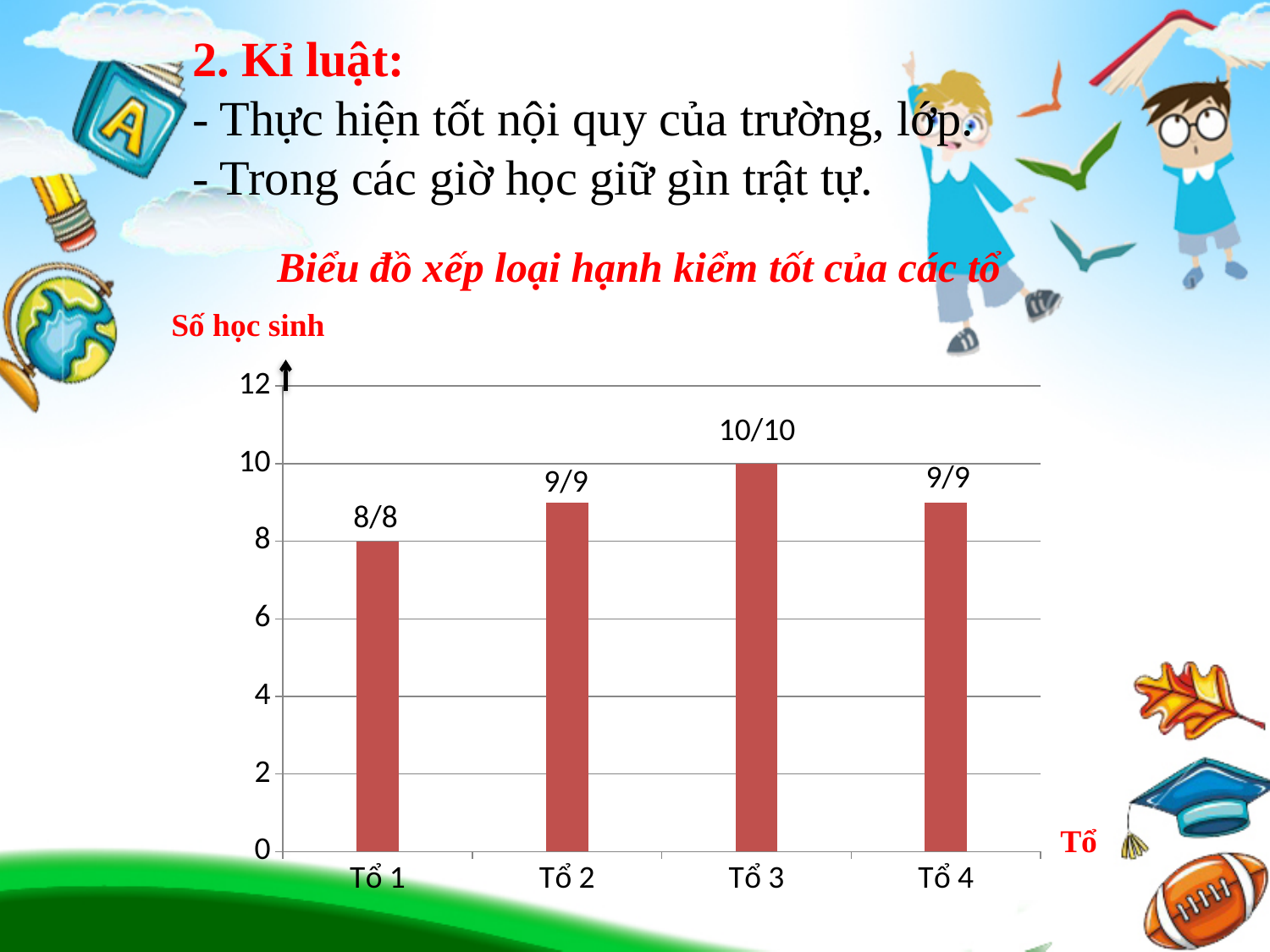
What is the data label shown above the bar for Tổ 1? 8/8 What is the data label shown above the bar for Tổ 3? 10/10 Which tổ has the tallest bar in the chart? Tổ 3 Is the value for Tổ 4 greater or less than 6? greater Which bar is taller, Tổ 3 or Tổ 1? Tổ 3 What kind of chart is shown on the slide? bar chart How many tổ (categories) are shown on the x axis of the chart? 4 What is the label on the vertical axis of the chart? Số học sinh How many more students does Tổ 3 have than Tổ 1 according to the bar heights? 2 What is the data label shown above the bar for Tổ 2? 9/9 What is the title of the chart? Biểu đồ xếp loại hạnh kiểm tốt của các tổ Which tổ has the shortest bar in the chart? Tổ 1